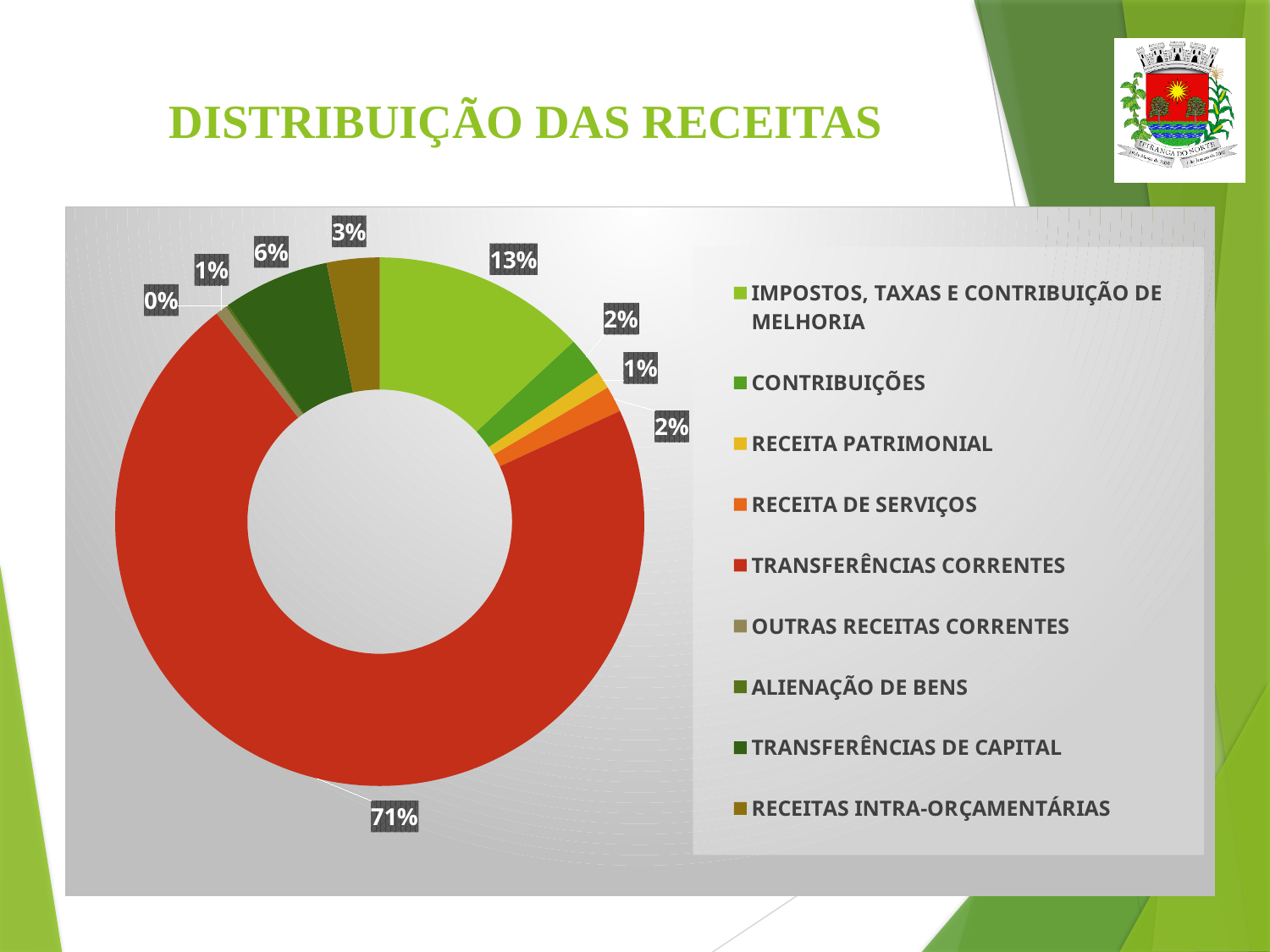
What is the smallest percentage value labelled on the chart? 0% What percentage is shown for TRANSFERÊNCIAS DE CAPITAL? 6% What is the title of the chart on the slide? DISTRIBUIÇÃO DAS RECEITAS Which is larger, the share for TRANSFERÊNCIAS DE CAPITAL or the share for RECEITAS INTRA-ORÇAMENTÁRIAS? TRANSFERÊNCIAS DE CAPITAL What colour represents TRANSFERÊNCIAS CORRENTES in the chart? Red What is the difference in percentage points between TRANSFERÊNCIAS CORRENTES and IMPOSTOS, TAXAS E CONTRIBUIÇÃO DE MELHORIA? 58 percentage points What percentage is shown for RECEITAS INTRA-ORÇAMENTÁRIAS? 3% How many categories does the legend list? 9 What share of the receitas is TRANSFERÊNCIAS CORRENTES? 71% Which category has the largest share of the chart? TRANSFERÊNCIAS CORRENTES What percentage is shown for IMPOSTOS, TAXAS E CONTRIBUIÇÃO DE MELHORIA? 13% What kind of chart is shown on the slide? Doughnut (pie) chart